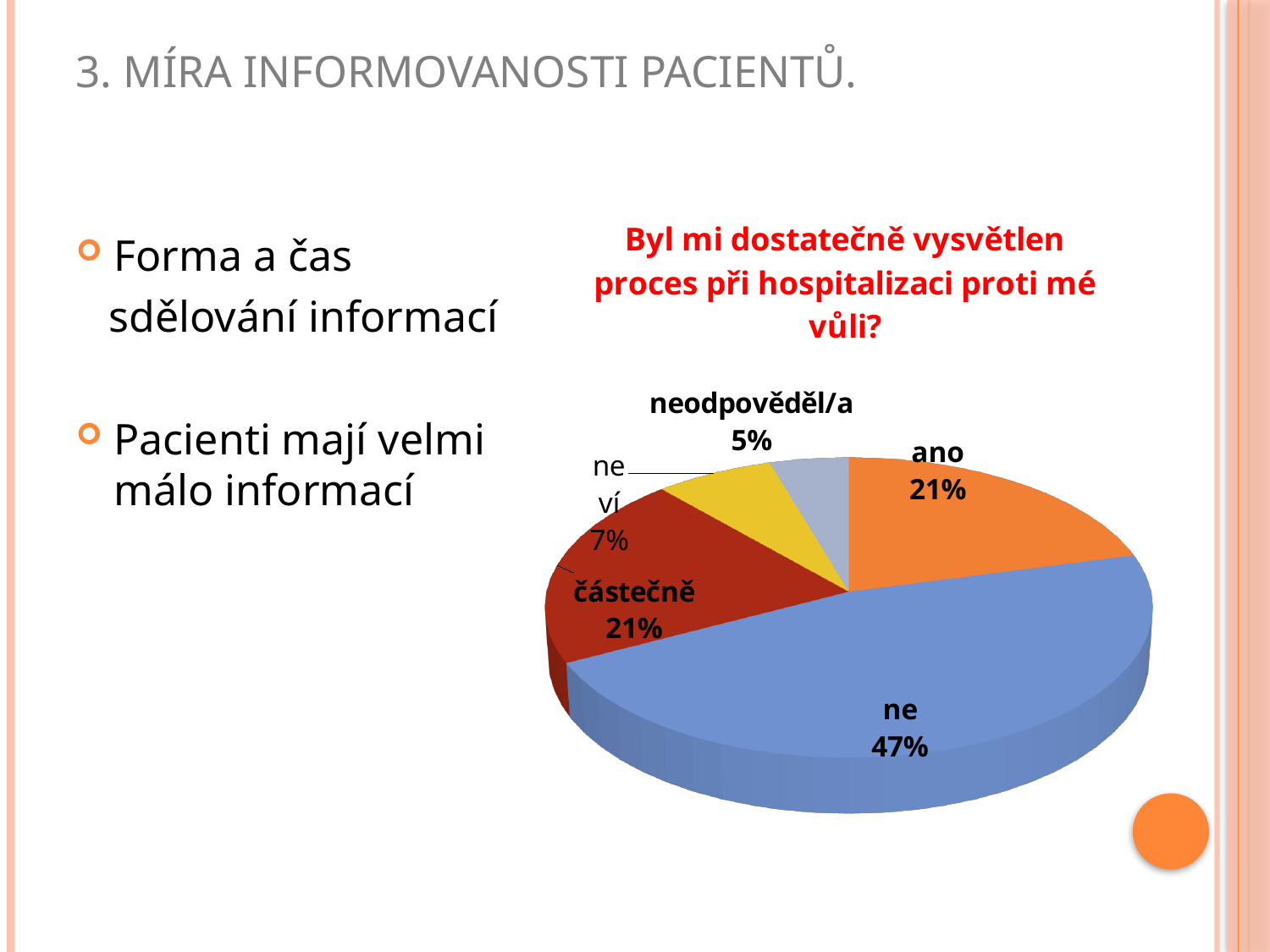
What colour is the "ne" slice of the pie? blue How many slices does the pie chart have? 5 What is the difference in percentage points between "ne" and "ano"? 26 What percentage of respondents answered "ne"? 47% What is the title of the chart? Byl mi dostatečně vysvětlen proces při hospitalizaci proti mé vůli? What share of the pie is labelled "nevím"? 7% Which answer has the smallest share of the pie? neodpověděl/a Which is larger, the share for "částečně" or the share for "nevím"? částečně What percentage of respondents answered "ano"? 21% Which answer has the largest share of the pie? ne What type of chart is shown on the slide? pie chart What percentage is shown for "neodpověděl/a"? 5%